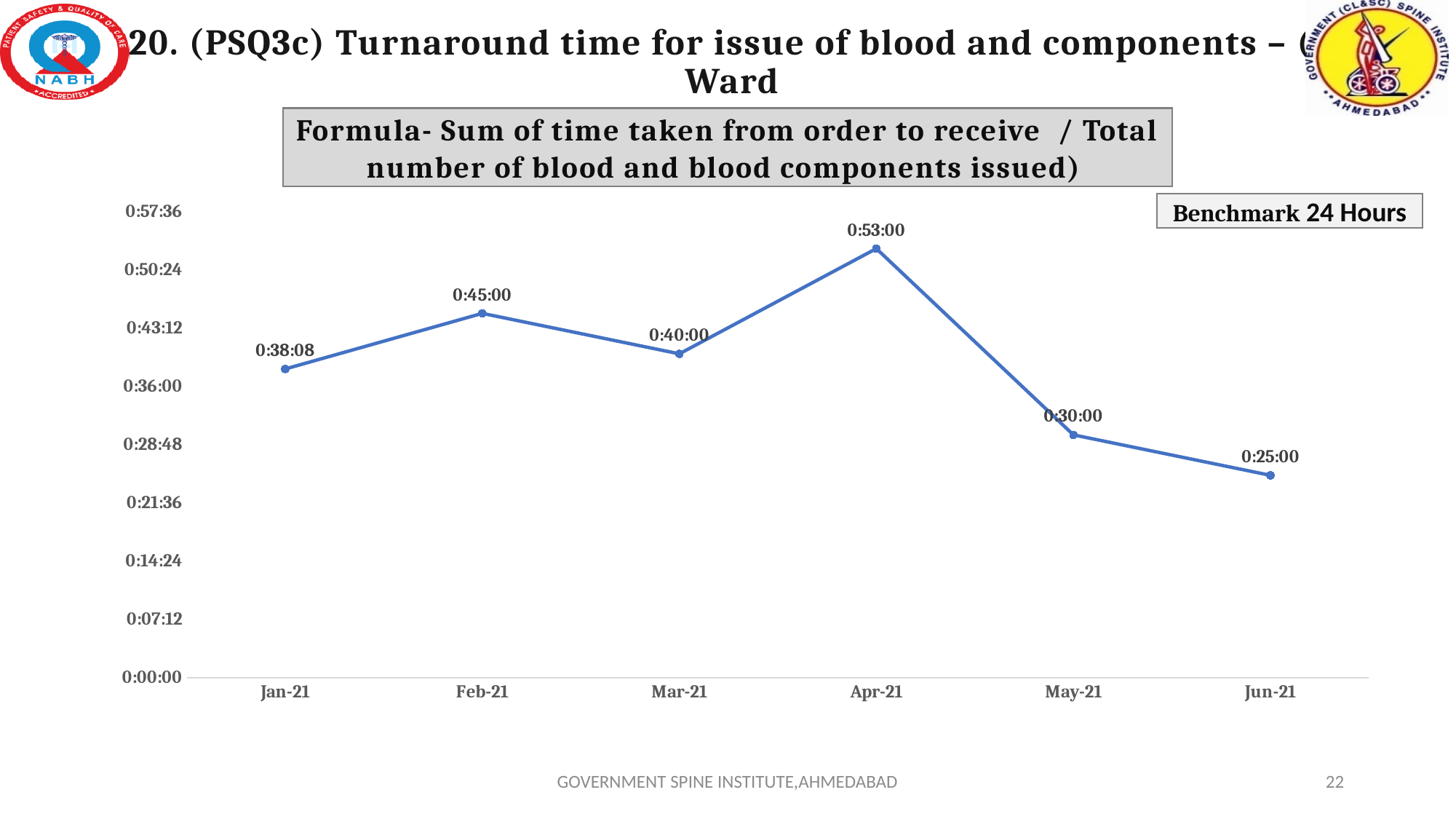
What is the turnaround time value for Jun-21? 0:25:00 What is the difference between the turnaround time in Apr-21 and Jun-21? 0:28:00 What is the turnaround time value for Jan-21? 0:38:08 What is the difference between the turnaround time in Feb-21 and Mar-21? 0:05:00 Do the turnaround time values rise or fall from Apr-21 to Jun-21? fall Which month has a larger turnaround time, Feb-21 or Mar-21? Feb-21 What kind of chart is shown on the slide? line chart Which month has the highest turnaround time? Apr-21 How many months are plotted on the chart? 6 Is the turnaround time for May-21 greater or less than 0:36:00? less What is the turnaround time value for Apr-21? 0:53:00 Which month has the lowest turnaround time? Jun-21